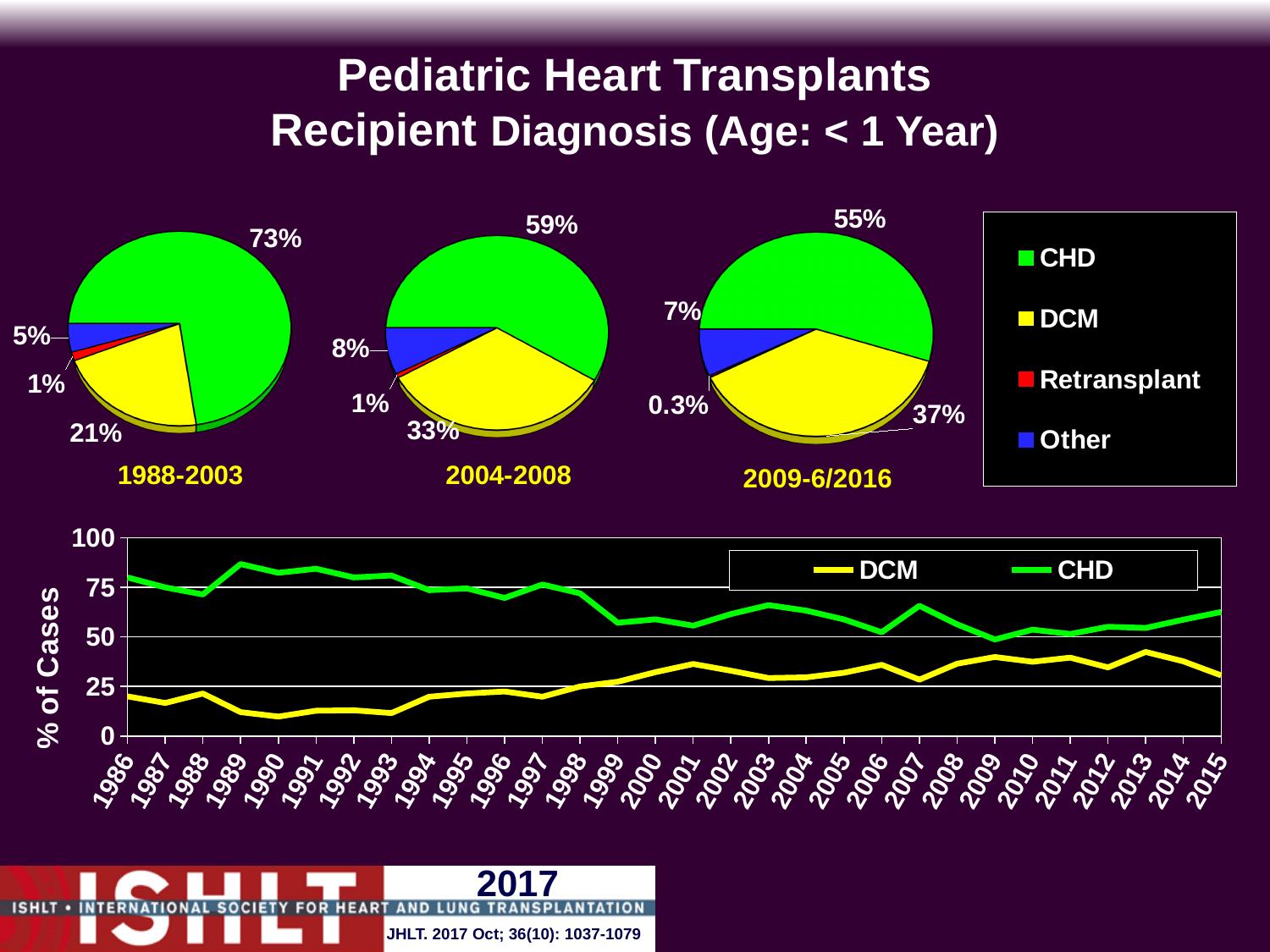
In the 2004-2008 pie chart, what share of cases is DCM? 33% In the 1988-2003 pie chart, which diagnosis has the smallest share? Retransplant In the 1988-2003 pie chart, what share of cases is CHD? 73% How many series does the legend of the bottom line chart list? 2 In the bottom line chart, is the CHD value for 1989 greater or less than 75? greater In the bottom line chart, does the CHD line generally rise or fall from 1986 to 2015? Fall How many diagnosis categories does the pie chart legend list? 4 In the 2009-6/2016 pie chart, which diagnosis has the largest share? CHD In the 2004-2008 pie chart, what is the difference between the CHD share and the DCM share? 26% Which is larger in the 2009-6/2016 pie chart: the Other share or the DCM share? DCM What kind of chart is the bottom chart showing % of Cases from 1986 to 2015? Line chart In the 2009-6/2016 pie chart, what share of cases is Retransplant? 0.3%